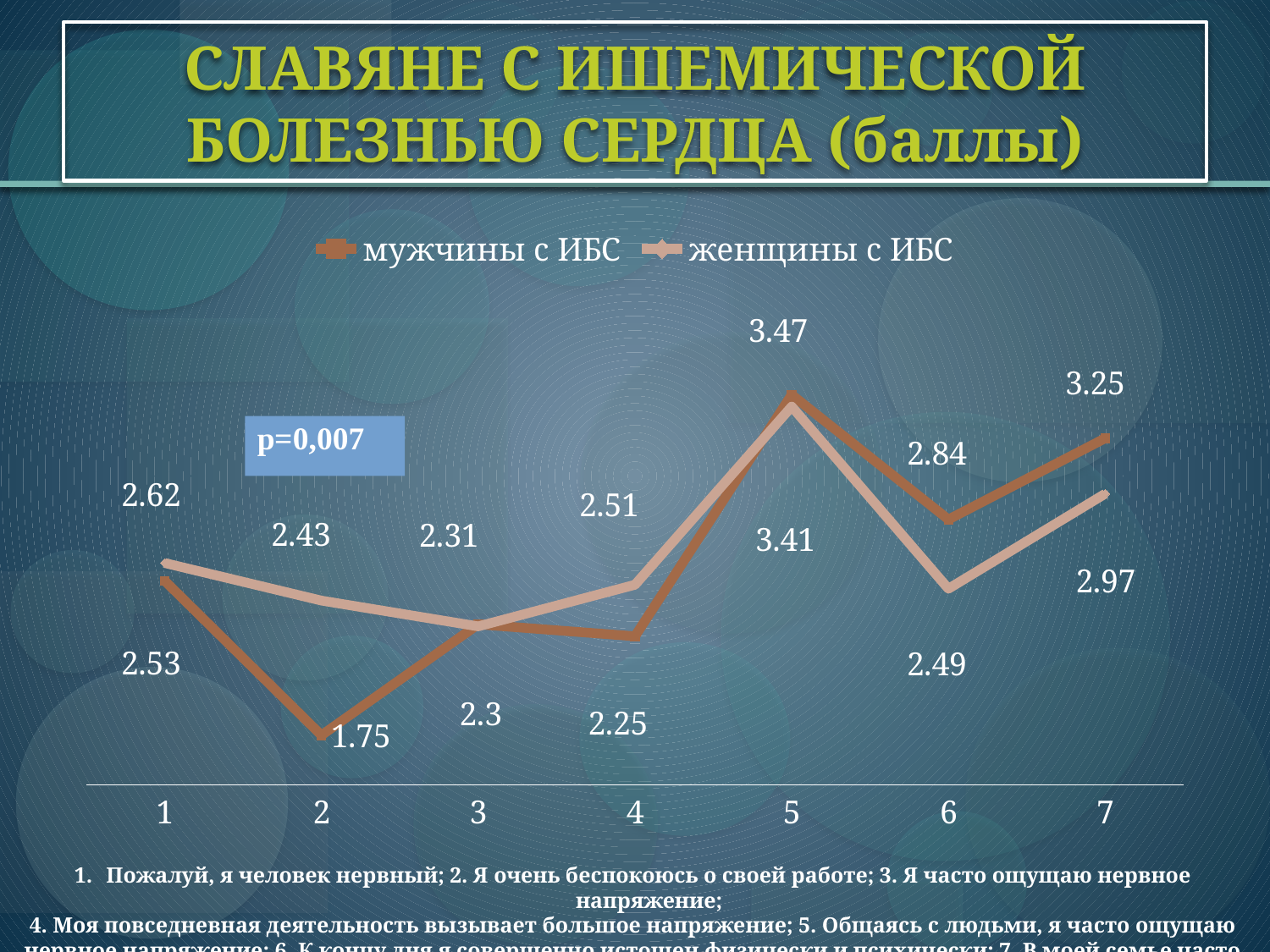
At which category does мужчины с ИБС have its lowest value? 2 What is the value for женщины с ИБС at category 1? 2.62 How many series does the legend list? 2 At which category does мужчины с ИБС reach its highest value? 5 What kind of chart is shown on the slide? line chart What is the value for мужчины с ИБС at category 7? 3.25 What is the value for женщины с ИБС at category 5? 3.41 Which series has the larger value at category 6? мужчины с ИБС At which category does женщины с ИБС have its lowest value? 3 What is the difference between мужчины с ИБС and женщины с ИБС at category 2? 0.68 What is the value for мужчины с ИБС at category 2? 1.75 How many categories are shown on the x axis? 7